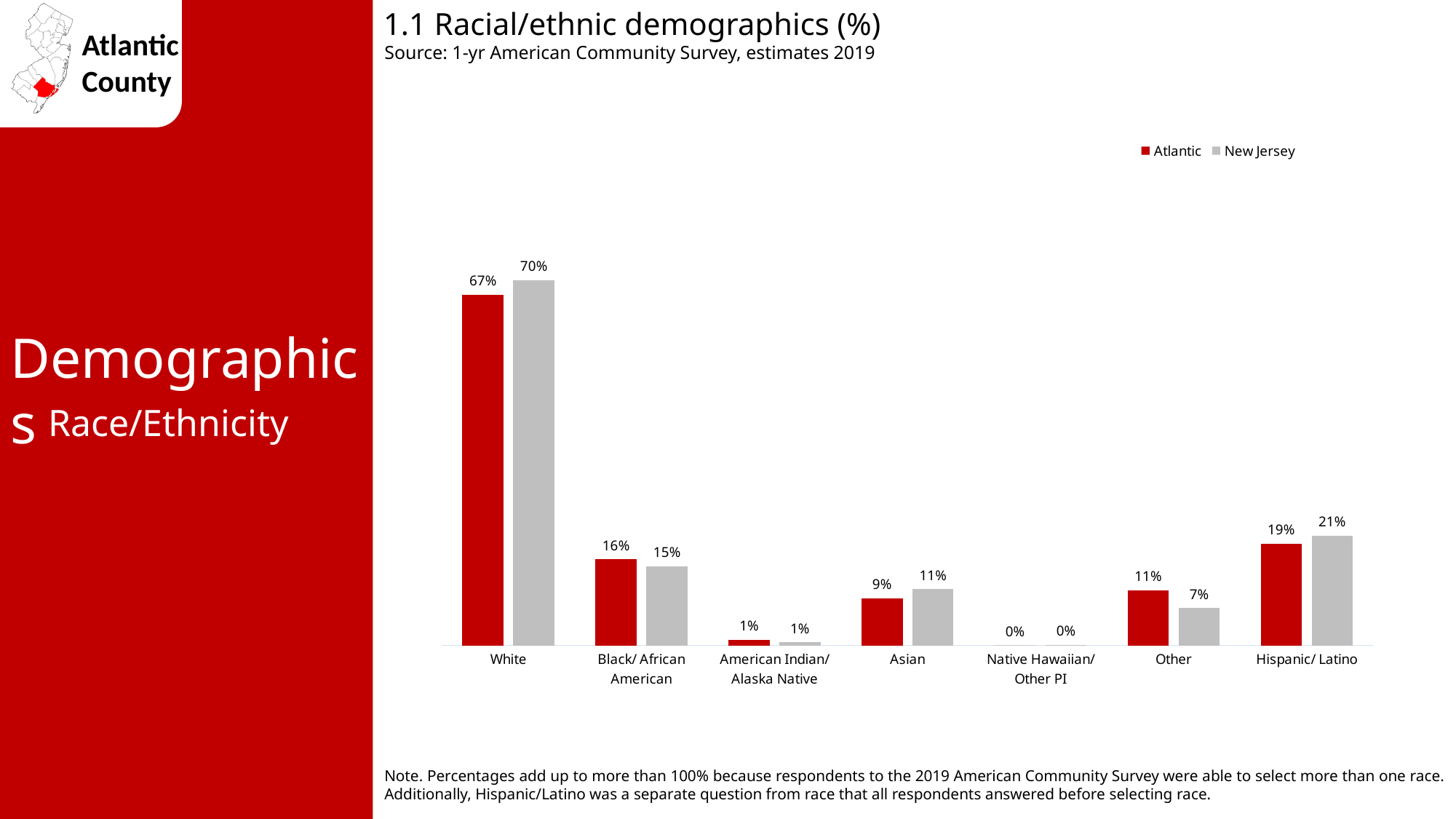
Which category has the lowest New Jersey value? Native Hawaiian/ Other PI For Black/ African American, which is larger: the Atlantic value or the New Jersey value? Atlantic What is the New Jersey value for Hispanic/ Latino? 21% What is the New Jersey value for Asian? 11% What is the Atlantic value for Other? 11% What is the difference between the Atlantic and New Jersey values for Other? 4% How many categories are shown on the x axis? 7 What kind of chart is shown on the slide? Bar chart What is the Atlantic value for White? 67% Which category has the highest Atlantic value? White What is the difference between the New Jersey and Atlantic values for White? 3% How many series does the legend list? 2